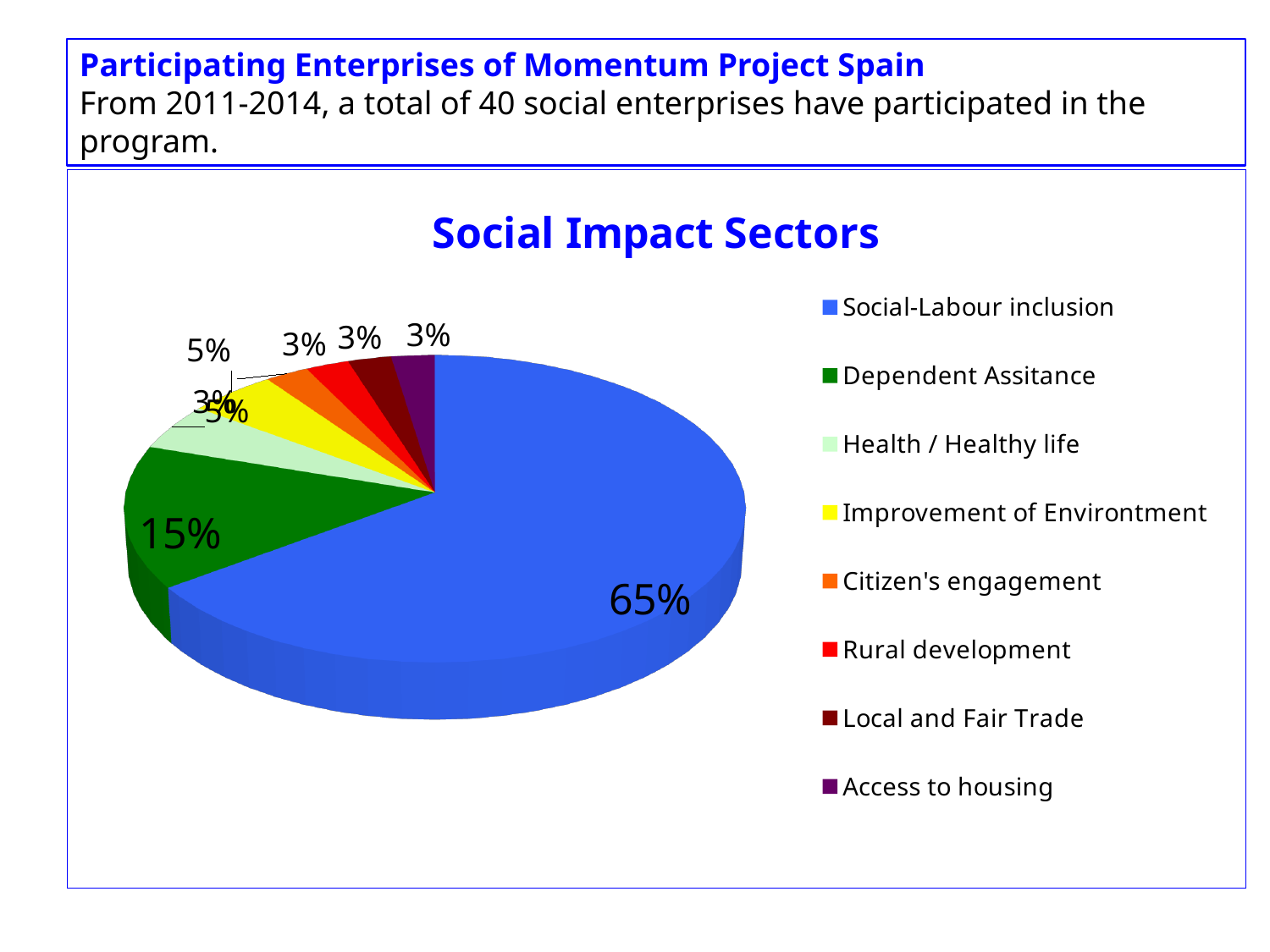
What percentage of the pie is Access to housing? 3% What colour represents Social-Labour inclusion in the chart? Blue Which has a larger share, Dependent Assitance or Rural development? Dependent Assitance What is the title of the chart? Social Impact Sectors What percentage of the pie is Improvement of Environtment? 5% Which sector has the largest share of the pie? Social-Labour inclusion What is the difference in percentage points between Social-Labour inclusion and Dependent Assitance? 50 percentage points What percentage of the pie is Dependent Assitance? 15% What type of chart is shown on the slide? Pie chart How many sectors are listed in the legend? 8 What percentage of the pie is Local and Fair Trade? 3% What percentage of the pie is Social-Labour inclusion? 65%